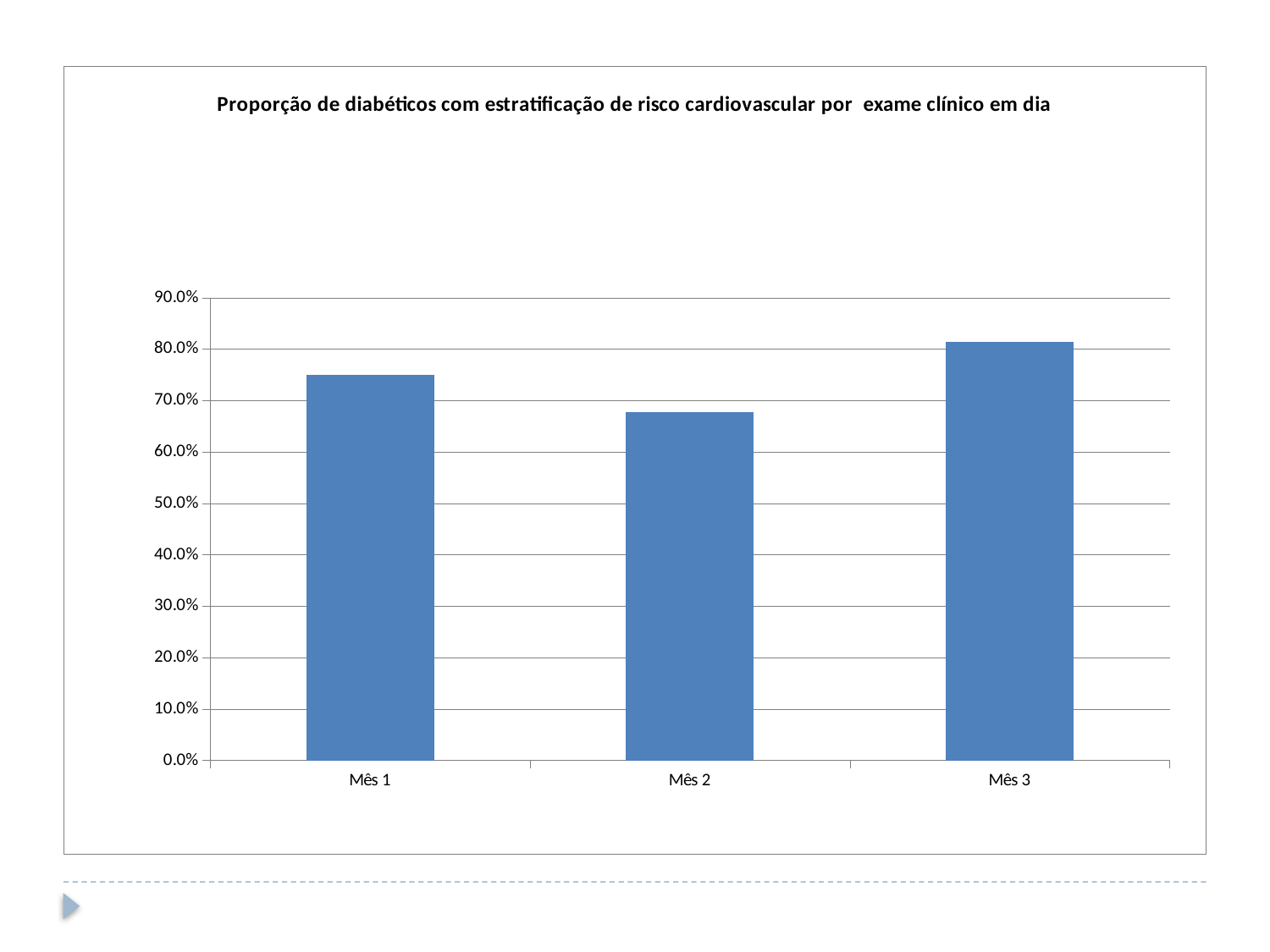
Is the value for Mês 1 greater or less than 70.0%? greater What kind of chart is shown on the slide? bar chart Which is larger, the value for Mês 1 or the value for Mês 2? Mês 1 Is the value for Mês 3 greater or less than 70.0%? greater Is the value for Mês 1 greater or less than 80.0%? less Which month has the highest value? Mês 3 What is the title of the chart? Proporção de diabéticos com estratificação de risco cardiovascular por exame clínico em dia Which is larger, the value for Mês 2 or the value for Mês 3? Mês 3 Which month has the lowest value? Mês 2 How many categories are plotted on the x axis? 3